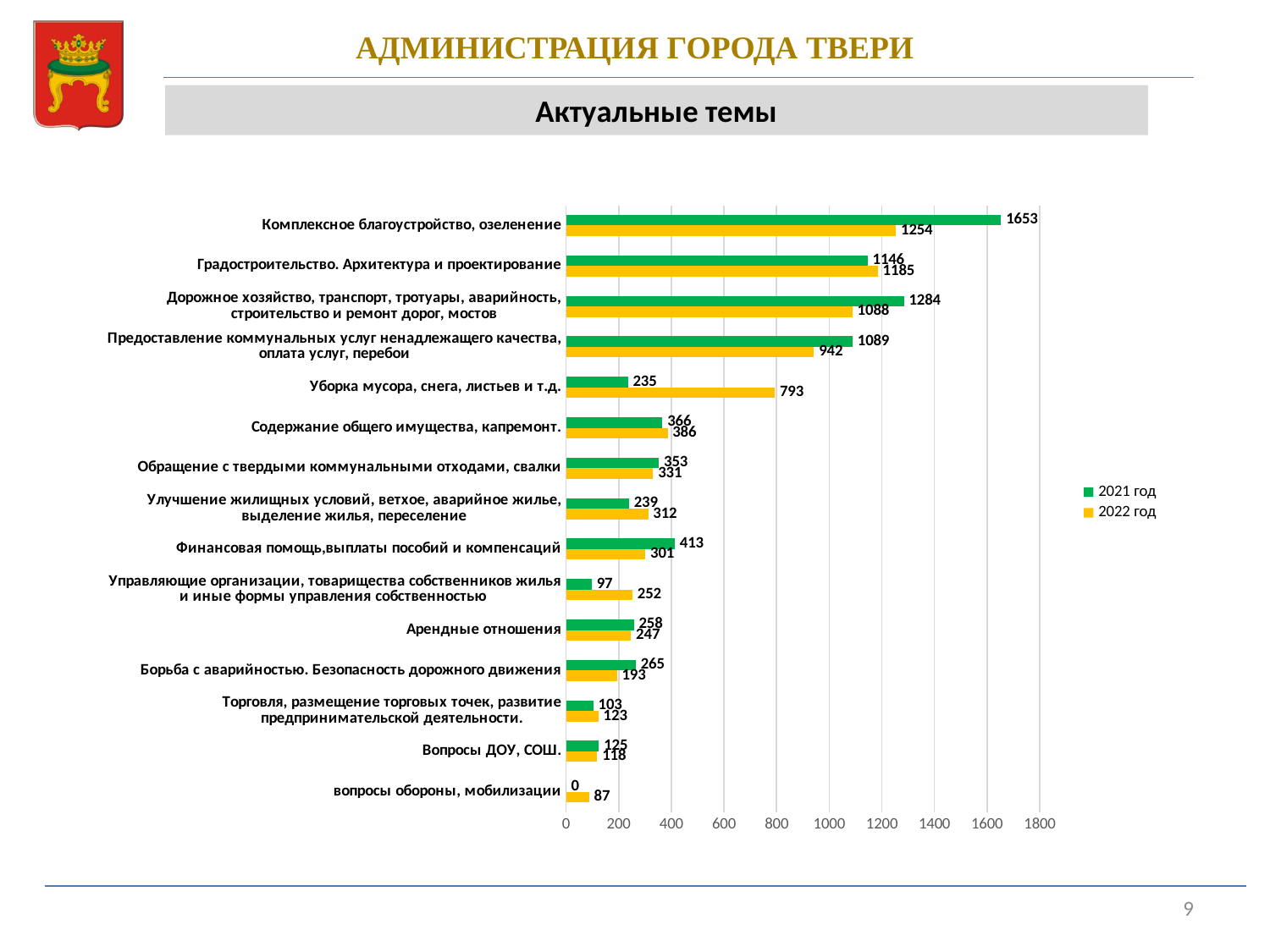
Which colour represents 2022 год in the chart? Yellow What kind of chart is shown on the slide? Bar chart How many categories are shown on the chart? 15 What is the value for 2021 год for "вопросы обороны, мобилизации"? 0 What is the value for 2022 год for "Уборка мусора, снега, листьев и т.д."? 793 What is the difference between the 2021 год and 2022 год values for "Комплексное благоустройство, озеленение"? 399 Which is larger for "Финансовая помощь,выплаты пособий и компенсаций": the 2021 год value or the 2022 год value? 2021 год How many series does the legend list? 2 Which is larger for "Управляющие организации, товарищества собственников жилья и иные формы управления собственностью": the 2021 год value or the 2022 год value? 2022 год What is the value for 2021 год for "Комплексное благоустройство, озеленение"? 1653 Which category has the highest value for 2022 год? Комплексное благоустройство, озеленение Which category has the lowest value for 2021 год? вопросы обороны, мобилизации